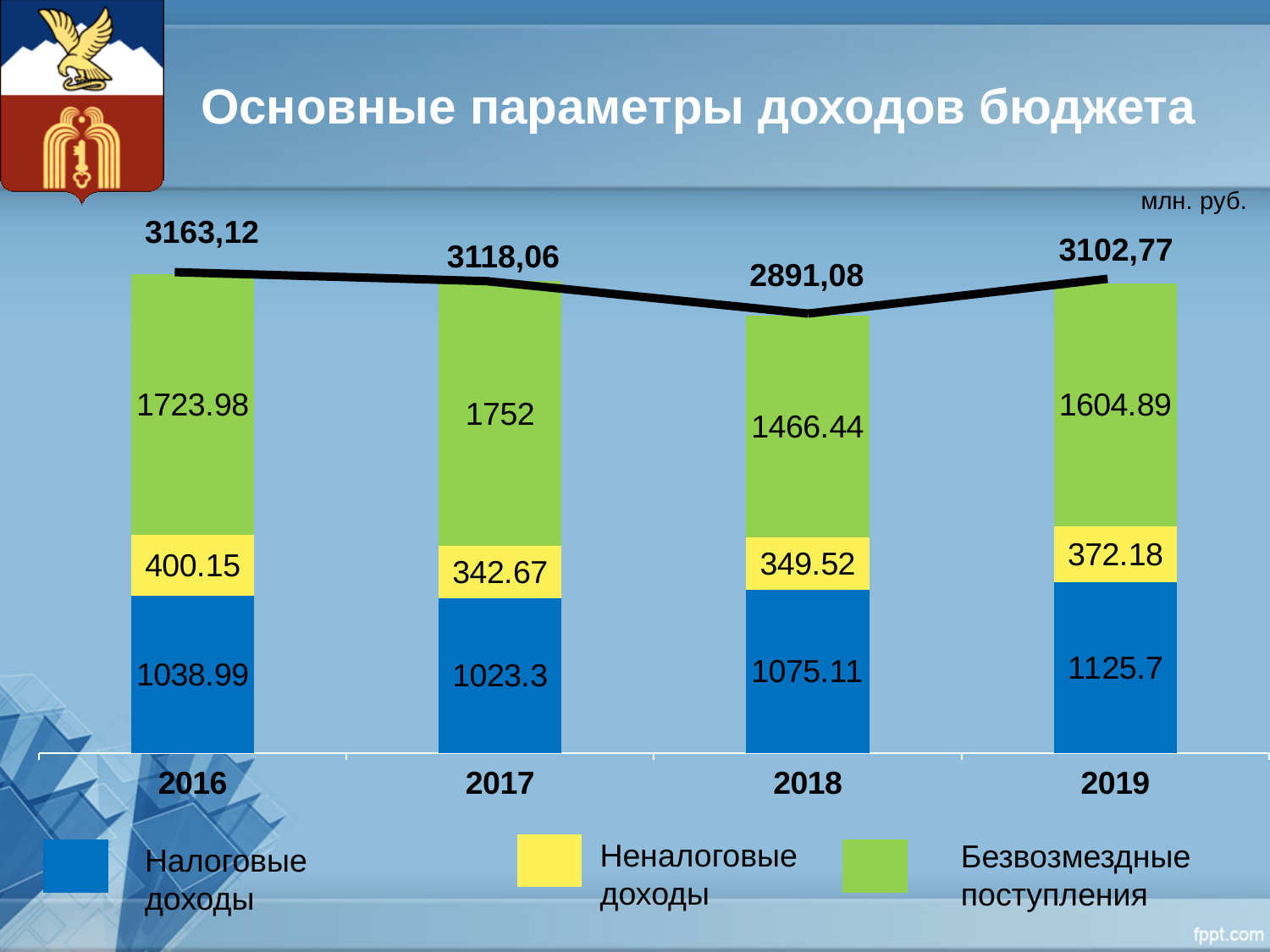
How many series does the legend list? 3 What is the value of Неналоговые доходы for 2019? 372.18 What kind of chart is shown on the slide? Stacked bar chart with a line Which is larger: Неналоговые доходы in 2016 or in 2017? 2016 What is the value of Налоговые доходы for 2016? 1038.99 Which year has the lowest total budget income shown on the line? 2018 In which year are Налоговые доходы the highest? 2019 What is the total budget income for 2017 as labelled on the line? 3118,06 In which year are Безвозмездные поступления the lowest? 2018 What is the difference between Налоговые доходы in 2019 and in 2016? 86.71 How many years are shown on the x axis? 4 What is the value of Безвозмездные поступления for 2018? 1466.44